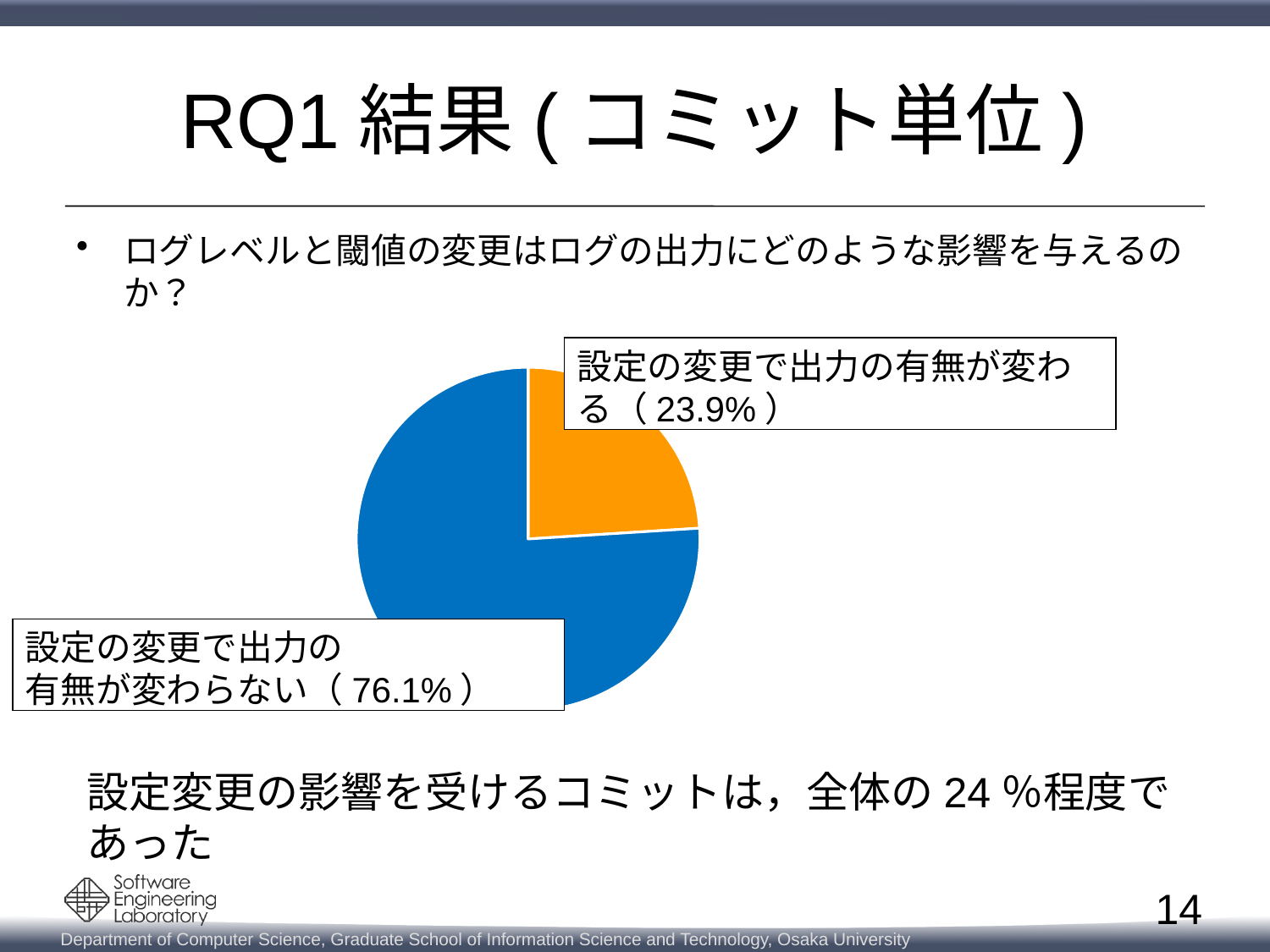
Which is larger: the 設定の変更で出力の有無が変わる slice or the 設定の変更で出力の有無が変わらない slice? 設定の変更で出力の有無が変わらない What kind of chart is shown on the slide? pie chart How many slices does the pie chart have? 2 Which slice of the pie chart is the largest? 設定の変更で出力の有無が変わらない What share of the pie is labelled 設定の変更で出力の有無が変わらない? 76.1% What colour is the slice labelled 設定の変更で出力の有無が変わる (23.9%)? orange Which slice of the pie chart is the smallest? 設定の変更で出力の有無が変わる What colour is the slice labelled 設定の変更で出力の有無が変わらない (76.1%)? blue What is the difference in percentage points between the 変わらない slice and the 変わる slice? 52.2 What share of the pie is labelled 設定の変更で出力の有無が変わる? 23.9%